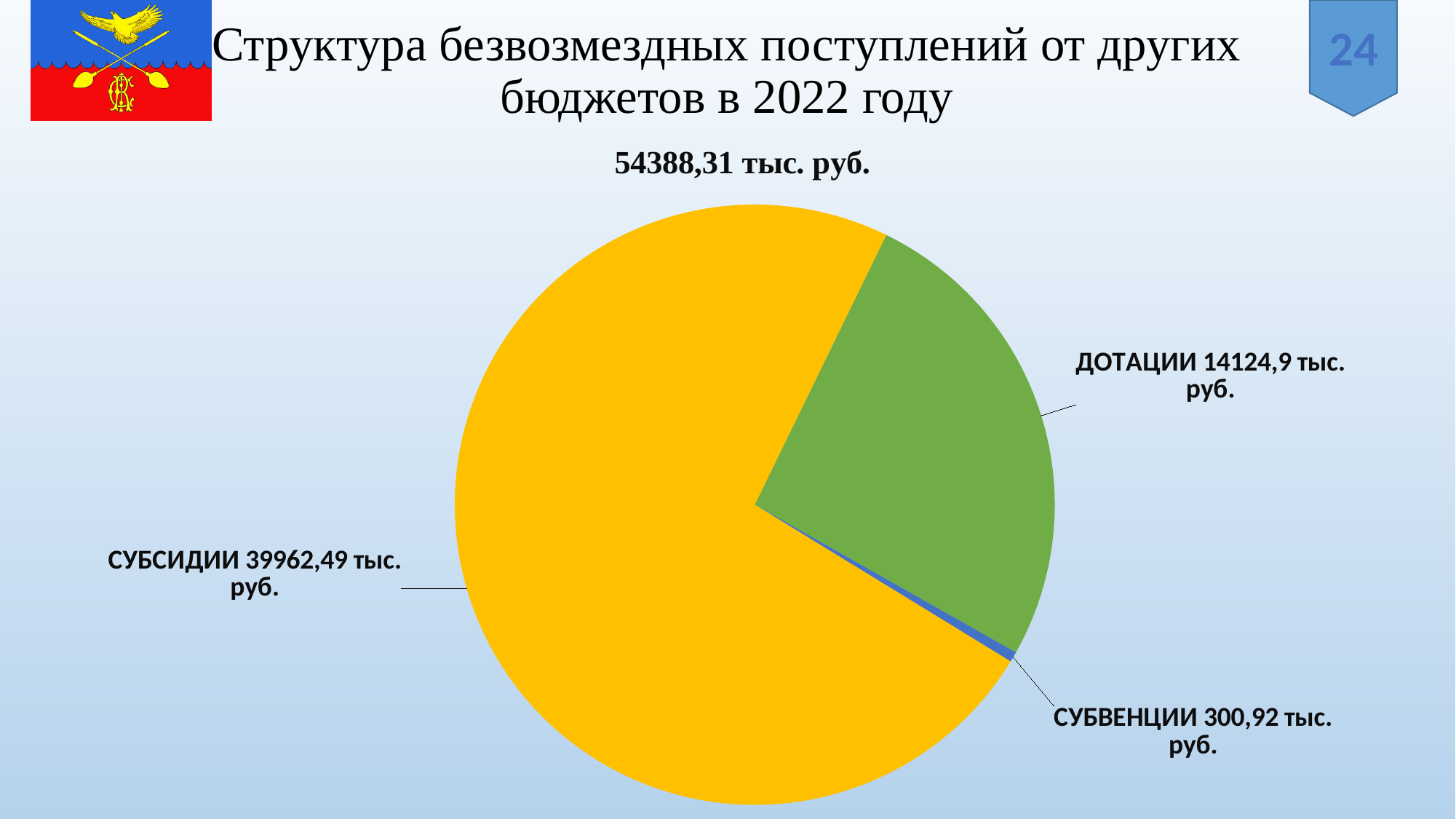
What is the value of the СУБВЕНЦИИ slice? 300,92 тыс. руб. What is the difference between the ДОТАЦИИ and СУБВЕНЦИИ values? 13823,98 тыс. руб. Which category has the smallest slice of the pie? СУБВЕНЦИИ How many slices does the pie chart have? 3 What is the value of the ДОТАЦИИ slice? 14124,9 тыс. руб. What is the difference between the СУБСИДИИ and ДОТАЦИИ values? 25837,59 тыс. руб. What is the value of the СУБСИДИИ slice? 39962,49 тыс. руб. Which is larger, ДОТАЦИИ or СУБВЕНЦИИ? ДОТАЦИИ What kind of chart is shown on the slide? Pie chart What colour is the ДОТАЦИИ slice? Green What total amount is shown as the chart title above the pie? 54388,31 тыс. руб. Which category has the largest slice of the pie? СУБСИДИИ